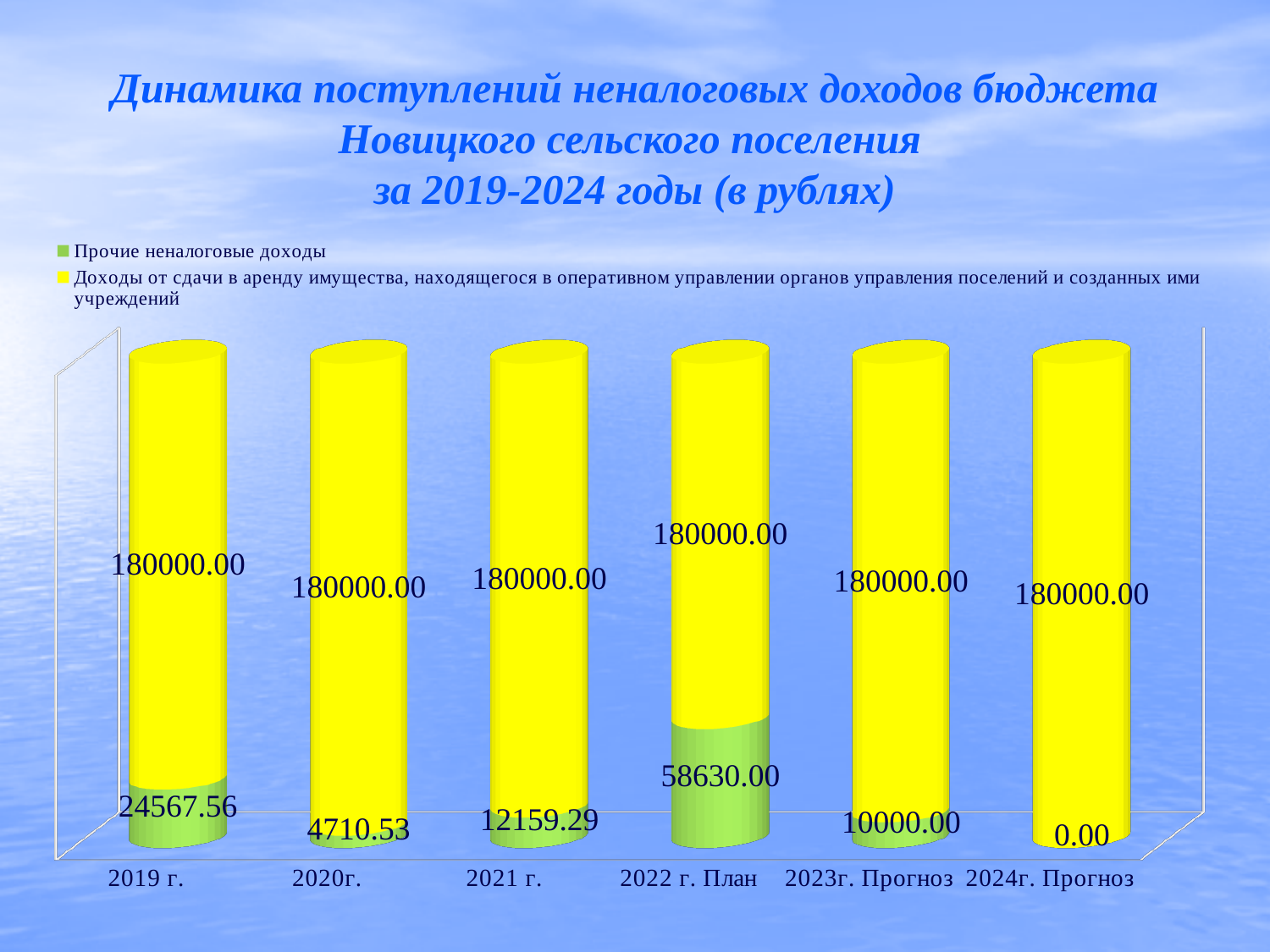
What is the value of Прочие неналоговые доходы for 2024г. Прогноз? 0.00 How many series does the legend list? 2 What is the value of Прочие неналоговые доходы for 2019 г.? 24567.56 Which category has the highest value for Прочие неналоговые доходы? 2022 г. План What is the value of Прочие неналоговые доходы for 2022 г. План? 58630.00 Which category has the lowest value for Прочие неналоговые доходы? 2024г. Прогноз How many categories are shown on the x axis? 6 What kind of chart is shown on the slide? Stacked bar chart What is the value of Доходы от сдачи в аренду имущества for 2021 г.? 180000.00 What is the difference between the Прочие неналоговые доходы values for 2019 г. and 2020г.? 19857.03 What is the total of the stacked bar for 2022 г. План? 238630.00 Which is larger, the Прочие неналоговые доходы value for 2021 г. or for 2023г. Прогноз? 2021 г.